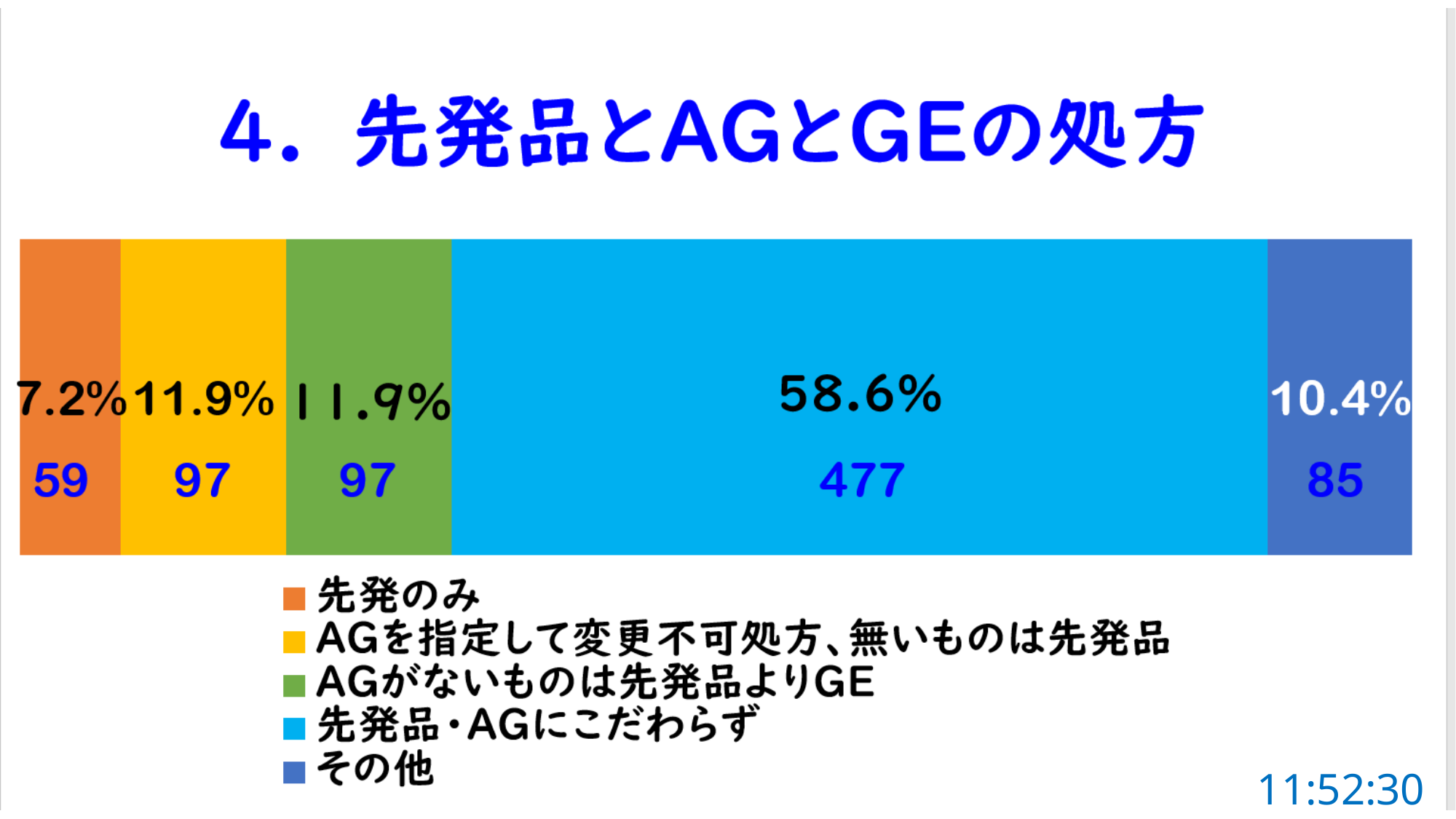
What kind of chart is shown on the slide? Stacked bar chart Which is larger, the count for その他 or the count for 先発のみ? その他 What count is shown for the その他 segment? 85 Which segment has the smallest value? 先発のみ How many entries does the legend list? 5 What is the total count across all segments of the bar? 815 What percentage is shown for the 先発品・AGにこだわらず segment? 58.6% What percentage is shown for the AGがないものは先発品よりGE segment? 11.9% How many segments does the stacked bar have? 5 What count is shown for the 先発のみ segment? 59 Which segment has the largest value? 先発品・AGにこだわらず What is the difference in count between 先発品・AGにこだわらず and その他? 392